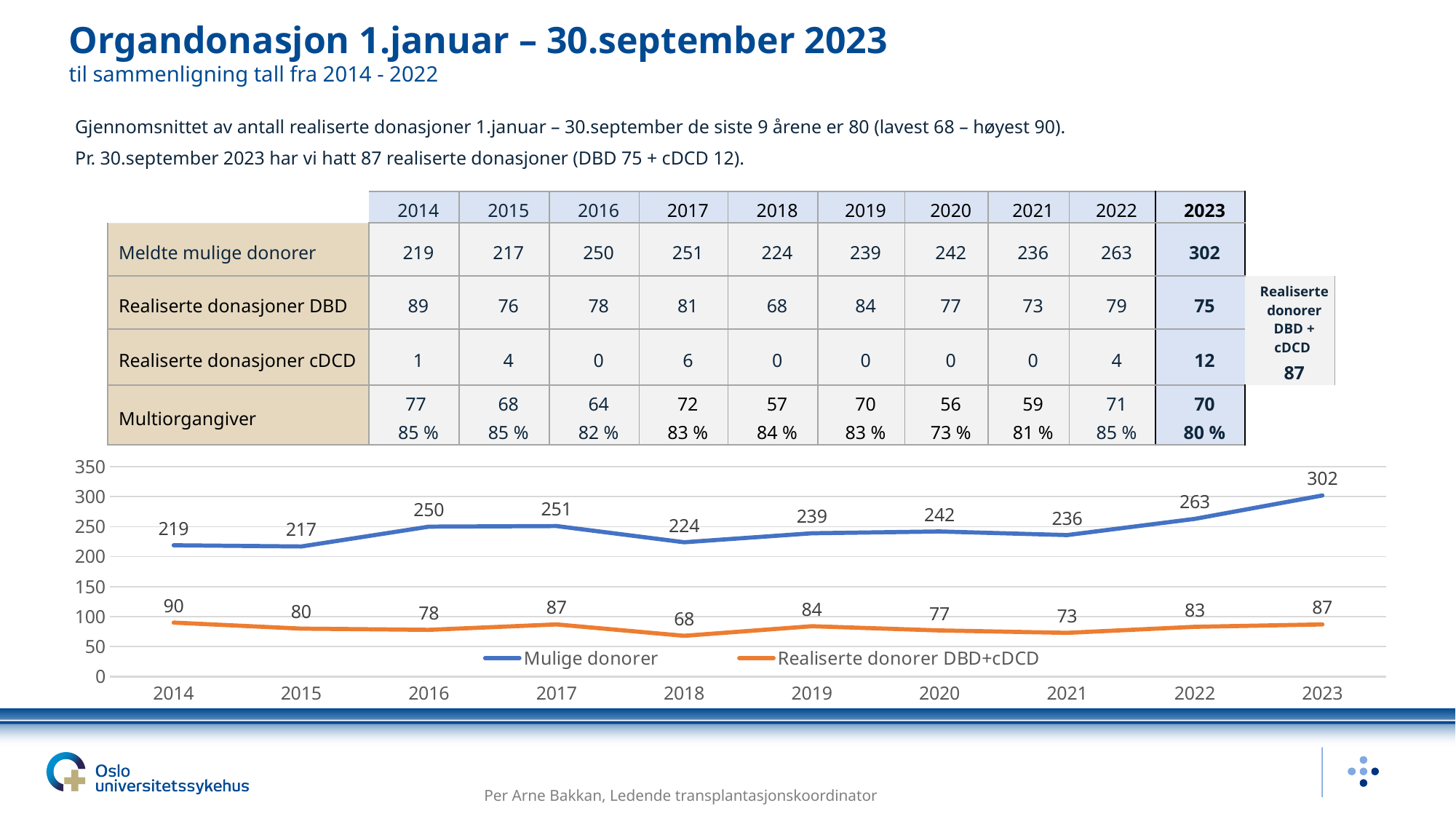
What is the value of Realiserte donorer DBD+cDCD in 2018? 68 What is the value of Mulige donorer in 2023? 302 Which year has the lowest value for Realiserte donorer DBD+cDCD? 2018 Does the Mulige donorer line rise or fall from 2021 to 2023? rise How many series does the chart legend list? 2 Is the value for Mulige donorer in 2016 greater or less than 200? greater How many years are shown on the x axis of the chart? 10 Which year has the highest value for Mulige donorer? 2023 What colour is the line for Realiserte donorer DBD+cDCD? orange What type of chart is shown on the slide? line chart Which is larger: Realiserte donorer DBD+cDCD in 2014 or in 2021? 2014 What is the difference between Mulige donorer in 2023 and in 2022? 39